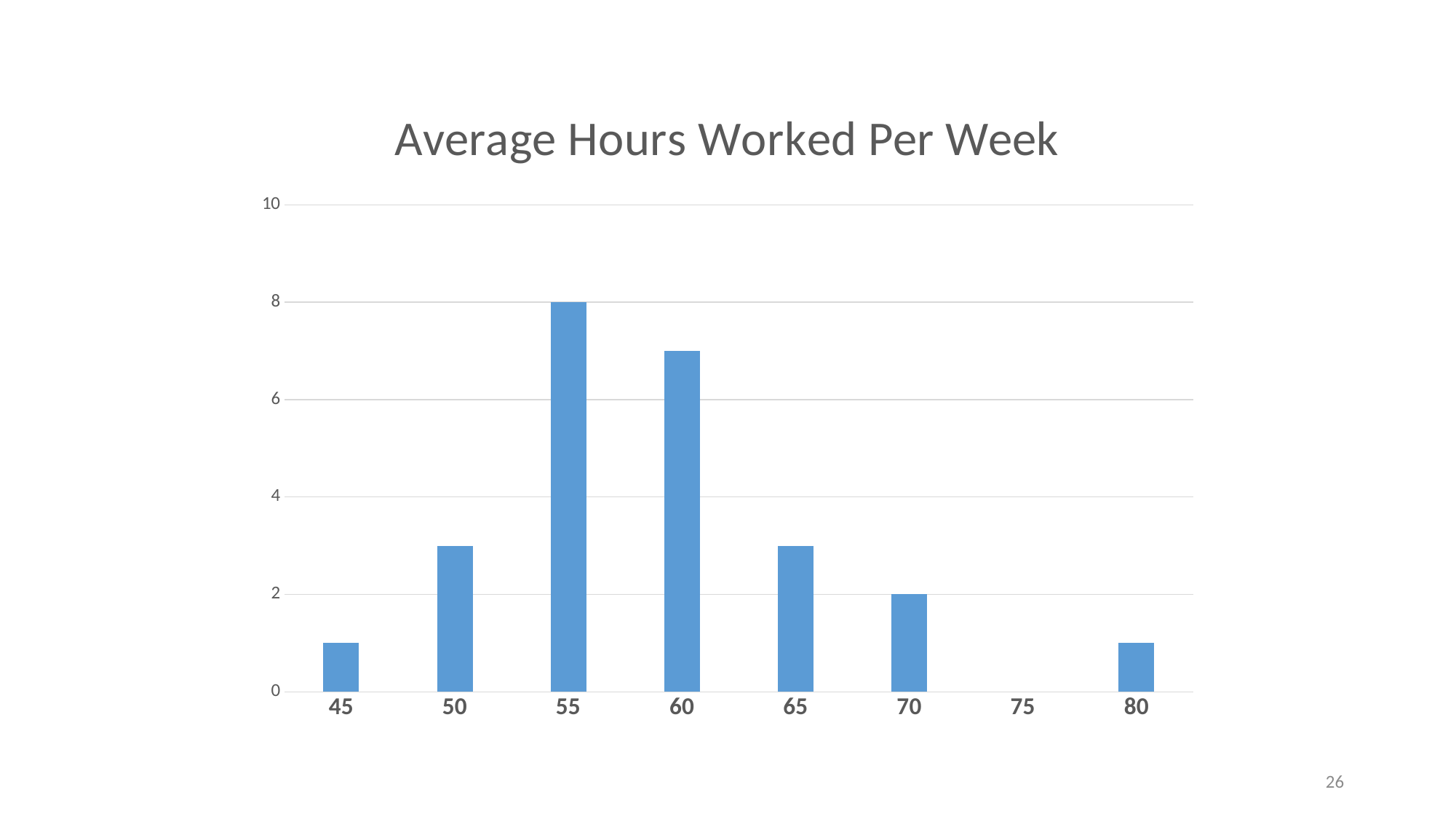
Is the value for 50 greater or less than 4? less Which has the larger value, 45 or 70? 70 What is the value for the 55 category? 8 What is the title of the chart? Average Hours Worked Per Week How many categories are shown on the x axis? 8 What kind of chart is shown on the slide? bar chart Which has the larger value, 55 or 60? 55 Is the value for 60 greater or less than 6? greater What is the value for the 70 category? 2 Which category has the lowest value? 75 What is the value for the 75 category? 0 Which category has the highest value? 55